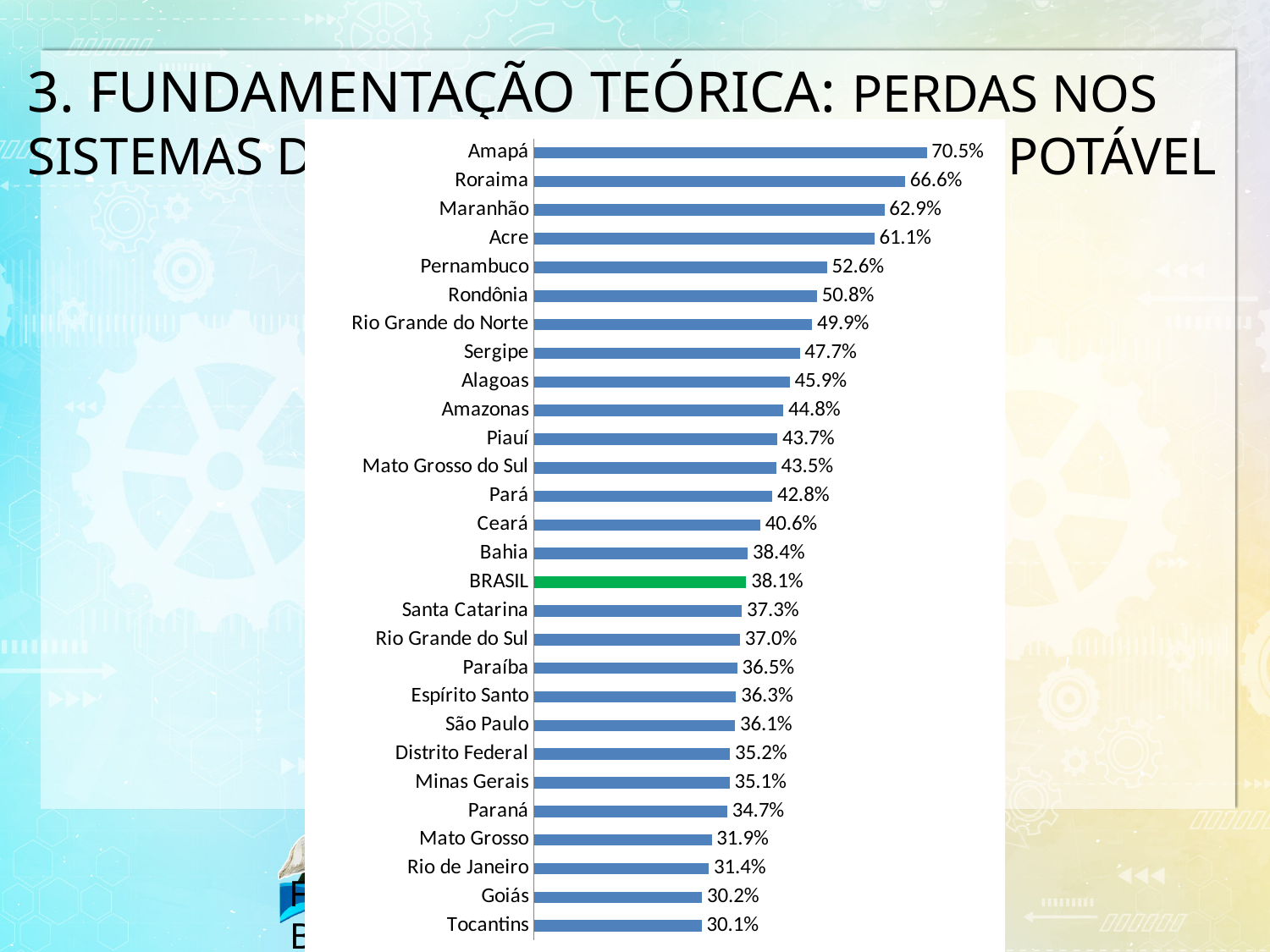
Which category has the lowest value? Tocantins Which bar is coloured green instead of blue? BRASIL What is the value shown for BRASIL? 38.1% What kind of chart is shown on the slide? Bar chart What is the difference between the values for Bahia and BRASIL? 0.3% Which has a larger value, Pernambuco or Ceará? Pernambuco Which category has the highest value? Amapá What is the value shown for Rio de Janeiro? 31.4% What is the difference between the values for Amapá and Tocantins? 40.4% What is the value shown for São Paulo? 36.1% How many categories are shown in the chart? 28 What is the value shown for Amapá? 70.5%